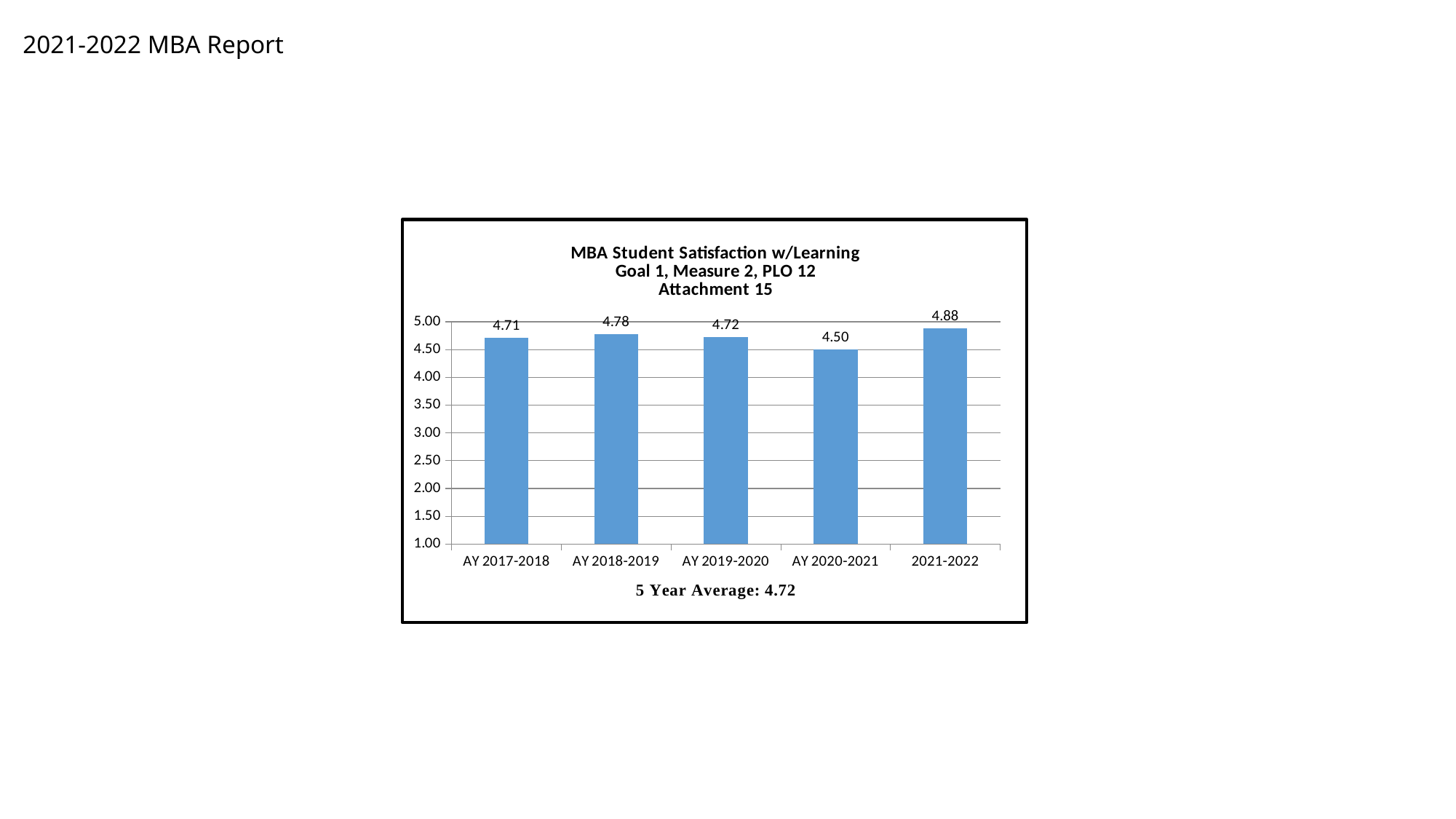
Does the value rise or fall from AY 2019-2020 to AY 2020-2021? fall What is the difference between the values for 2021-2022 and AY 2020-2021? 0.38 What is the value for AY 2017-2018? 4.71 What is the value for 2021-2022? 4.88 Is the value for AY 2020-2021 greater or less than 4.00? greater Which academic year has the highest value? 2021-2022 How many academic years are shown on the x axis? 5 What kind of chart is shown? bar chart Which is larger, the value for AY 2018-2019 or the value for AY 2019-2020? AY 2018-2019 What is the value for AY 2020-2021? 4.50 Which academic year has the lowest value? AY 2020-2021 What 5 year average is stated below the chart? 4.72